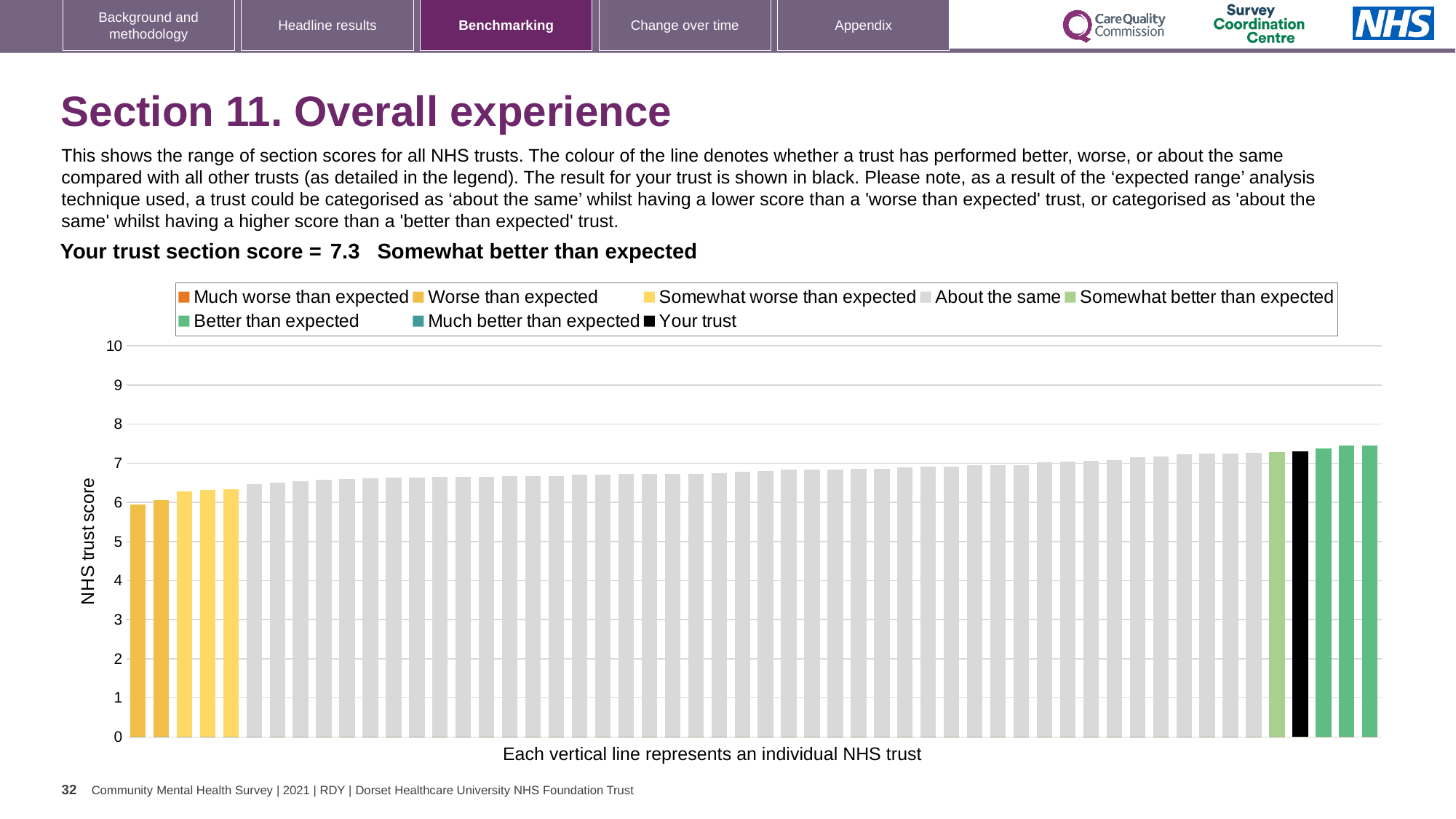
Is the value of the shortest bar greater or less than 5? greater Do the bar values rise or fall from left to right along the x axis? rise Is the value for your trust (the black bar) greater or less than 7? greater How many bars are coloured as 'Better than expected' (the darker green bars)? 3 What is the label on the y axis of the chart? NHS trust score How many bars are coloured as 'Somewhat better than expected' (the light green bar)? 1 Is the value of the tallest bar greater or less than 8? less How many entries does the chart legend list? 8 What is the section score for your trust (the black bar)? 7.3 How many bars are coloured as 'Worse than expected' (the darker yellow bars)? 2 What kind of chart is shown on the slide? bar chart What colour is the bar representing your trust? black